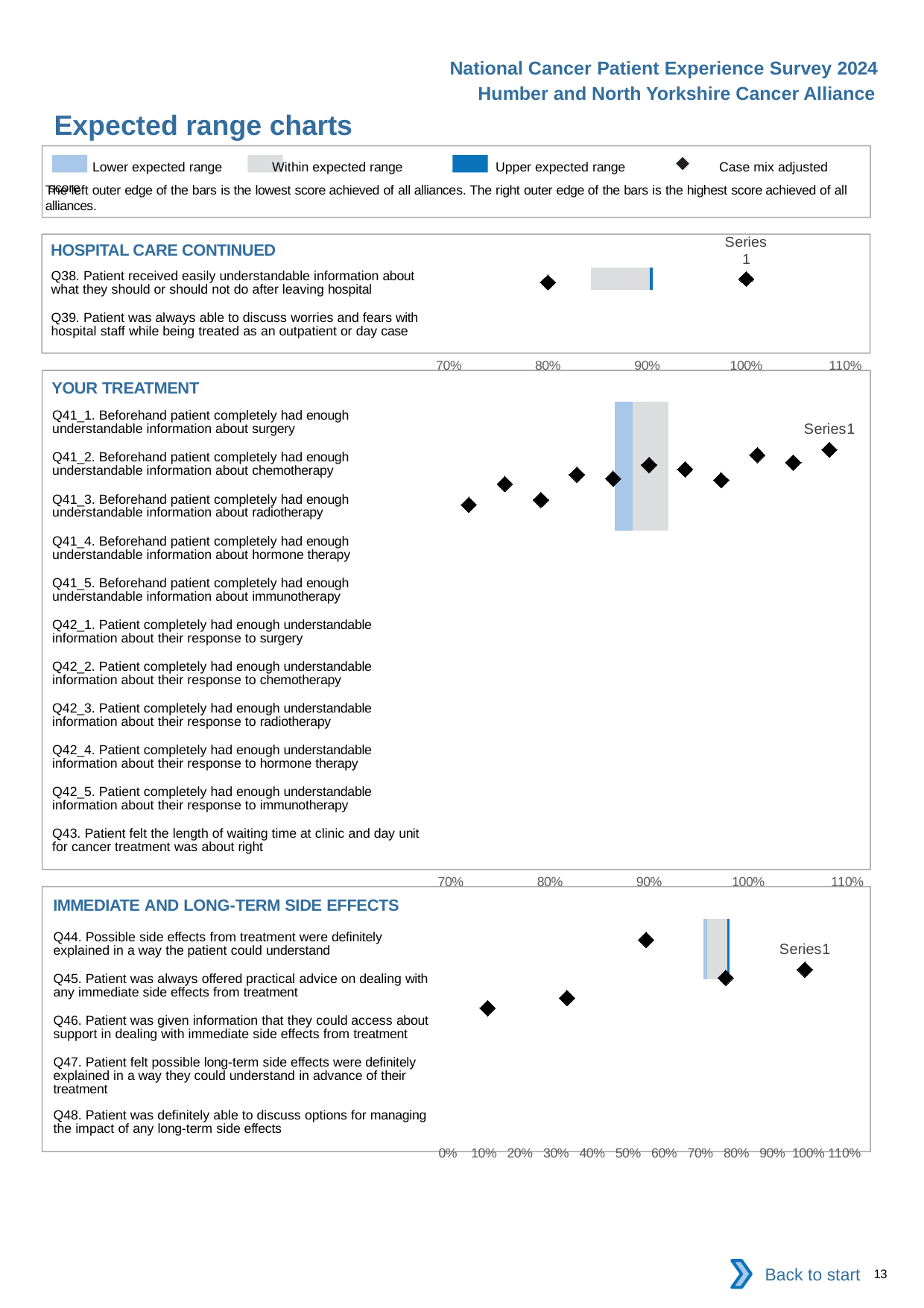
According to the legend, what does the black diamond marker represent? Case mix adjusted score How many entries does the legend at the top of the slide list? 4 What is the lowest value shown on the x axis of the IMMEDIATE AND LONG-TERM SIDE EFFECTS chart? 0% What is the highest value shown on the x axis of the HOSPITAL CARE CONTINUED chart? 110% How many questions are listed in the YOUR TREATMENT chart? 11 How many questions are listed in the IMMEDIATE AND LONG-TERM SIDE EFFECTS chart? 5 How many questions are listed in the HOSPITAL CARE CONTINUED chart? 2 What is the lowest value shown on the x axis of the YOUR TREATMENT chart? 70% What is the title of the slide? Expected range charts